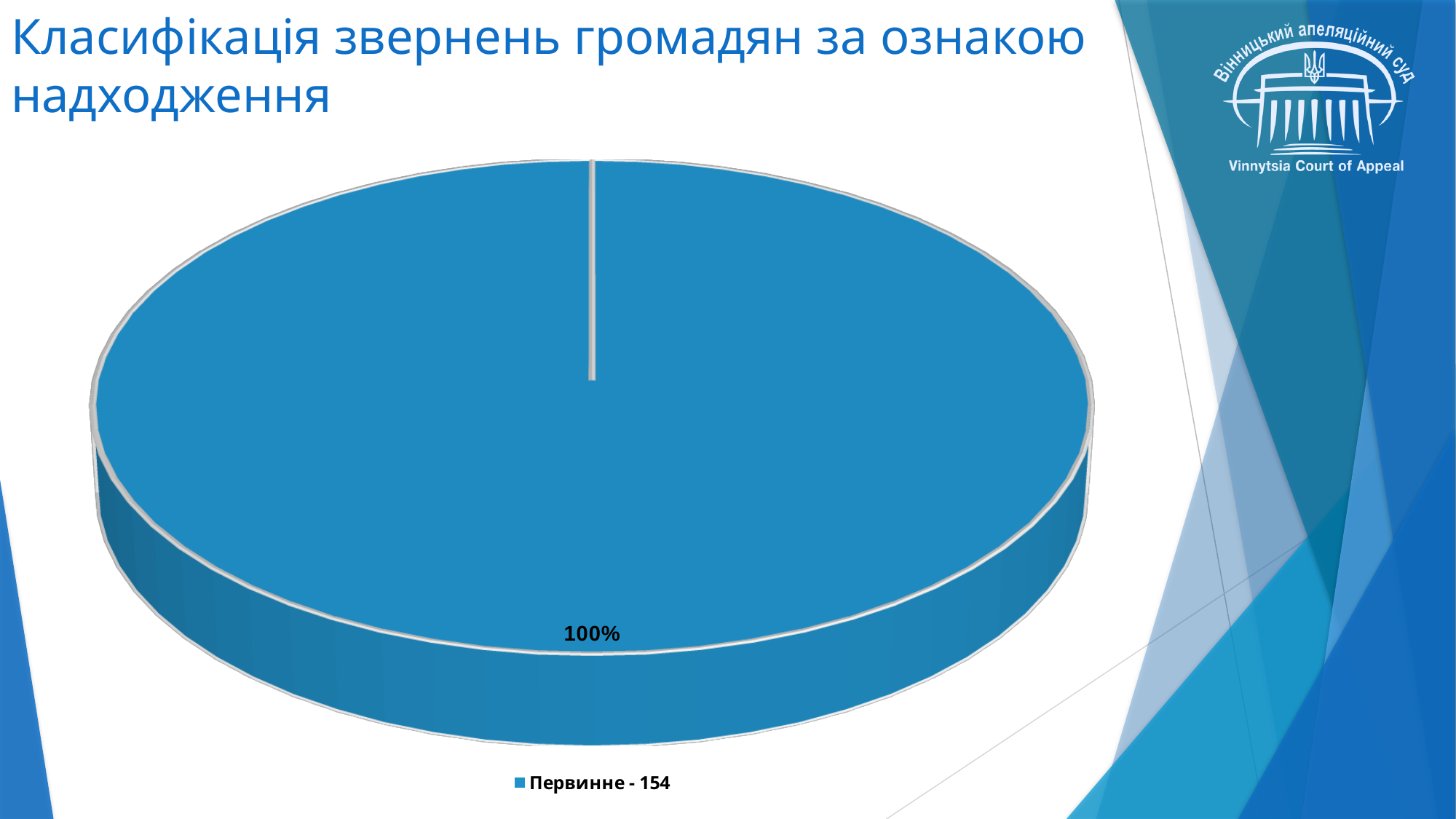
What share of the pie does the slice labelled in the legend as "Первинне - 154" represent? 100% What number is given for "Первинне" in the legend? 154 What is the data label printed on the pie slice? 100% How many entries does the legend list? 1 What is the legend entry shown below the pie chart? Первинне - 154 What kind of chart is shown on the slide? pie chart What is the title of the slide containing the pie chart? Класифікація звернень громадян за ознакою надходження How many slices does the pie chart have? 1